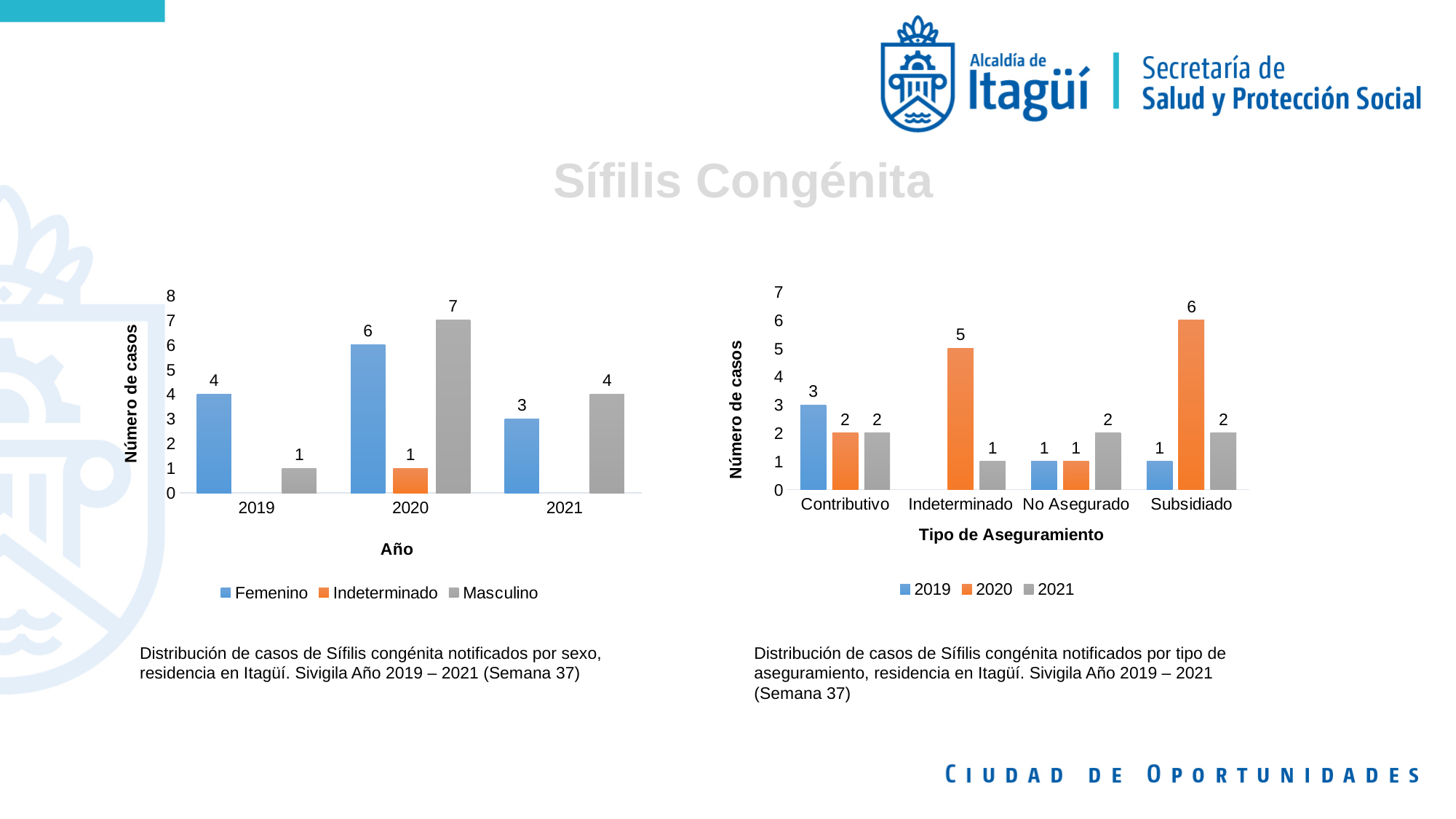
In the right chart (cases by tipo de aseguramiento), what is the value for 2020 in Subsidiado? 6 In the left chart (cases by sex), what is the value for Femenino in 2019? 4 In the right chart (cases by tipo de aseguramiento), what is the label of the x axis? Tipo de Aseguramiento In the right chart (cases by tipo de aseguramiento), which category has the highest 2020 value? Subsidiado In the left chart (cases by sex), what is the value for Masculino in 2020? 7 In the left chart (cases by sex), what is the difference between Masculino and Femenino in 2021? 1 In the left chart (cases by sex), which year has the highest Femenino value? 2020 In the right chart (cases by tipo de aseguramiento), which is larger: 2020 in Indeterminado or 2021 in Indeterminado? 2020 in Indeterminado In the right chart (cases by tipo de aseguramiento), how many categories are shown on the x axis? 4 In the left chart (cases by sex), how many series does the legend list? 3 In the right chart (cases by tipo de aseguramiento), what is the value for 2019 in Contributivo? 3 In the left chart (cases by sex), what kind of chart is it? Bar chart